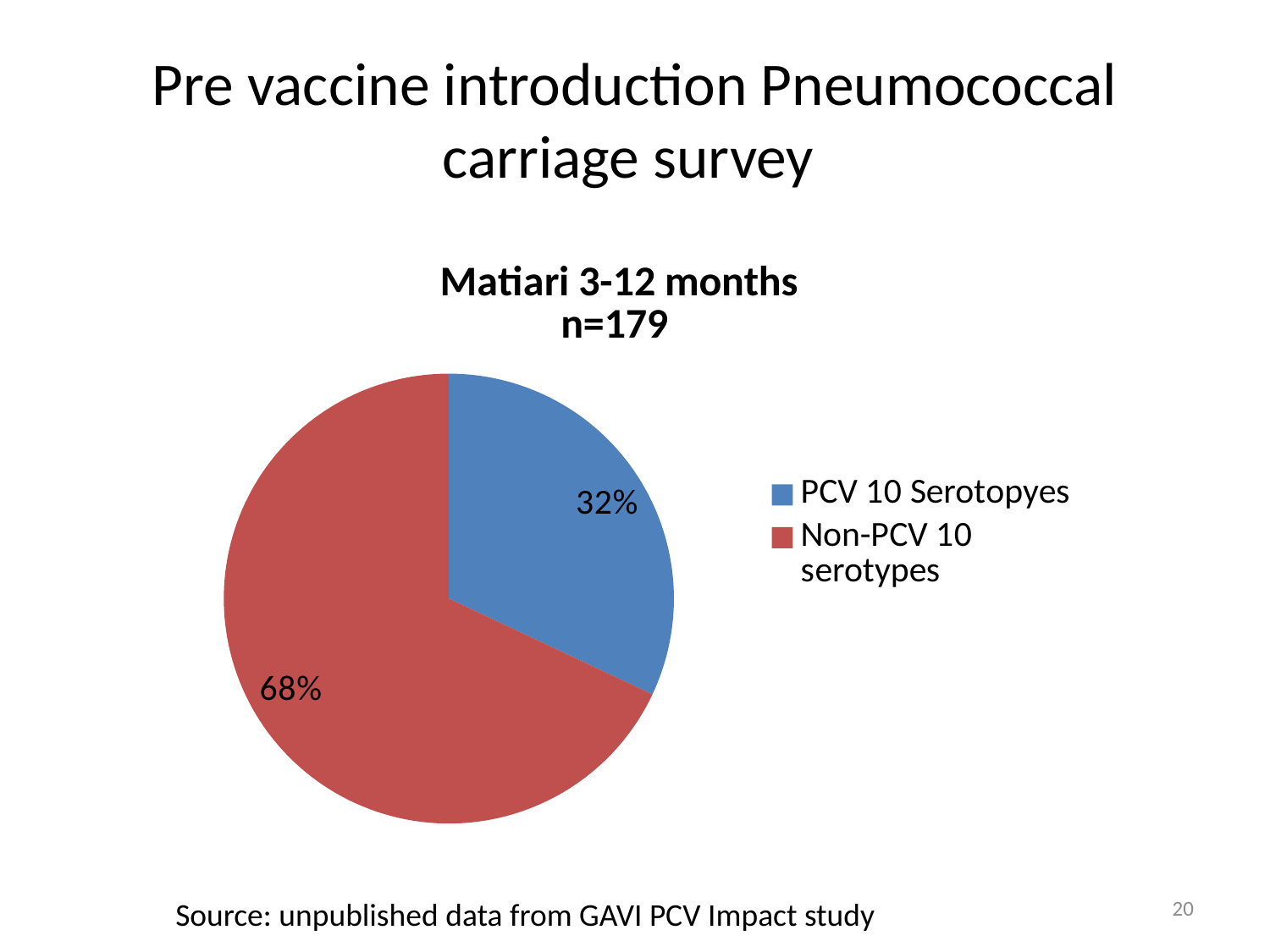
What share of the pie is PCV 10 Serotopyes? 32% What is the title of the pie chart? Matiari 3-12 months n=179 Which slice is the smallest? PCV 10 Serotopyes How many slices does the pie chart have? 2 What share of the pie is Non-PCV 10 serotypes? 68% What colour is the Non-PCV 10 serotypes slice? red What is the difference in percentage points between the Non-PCV 10 serotypes slice and the PCV 10 Serotopyes slice? 36 How many entries does the legend list? 2 What is the sample size (n) shown in the chart title? 179 Which slice is the largest? Non-PCV 10 serotypes What kind of chart is shown on the slide? pie chart Which is larger, the PCV 10 Serotopyes slice or the Non-PCV 10 serotypes slice? Non-PCV 10 serotypes